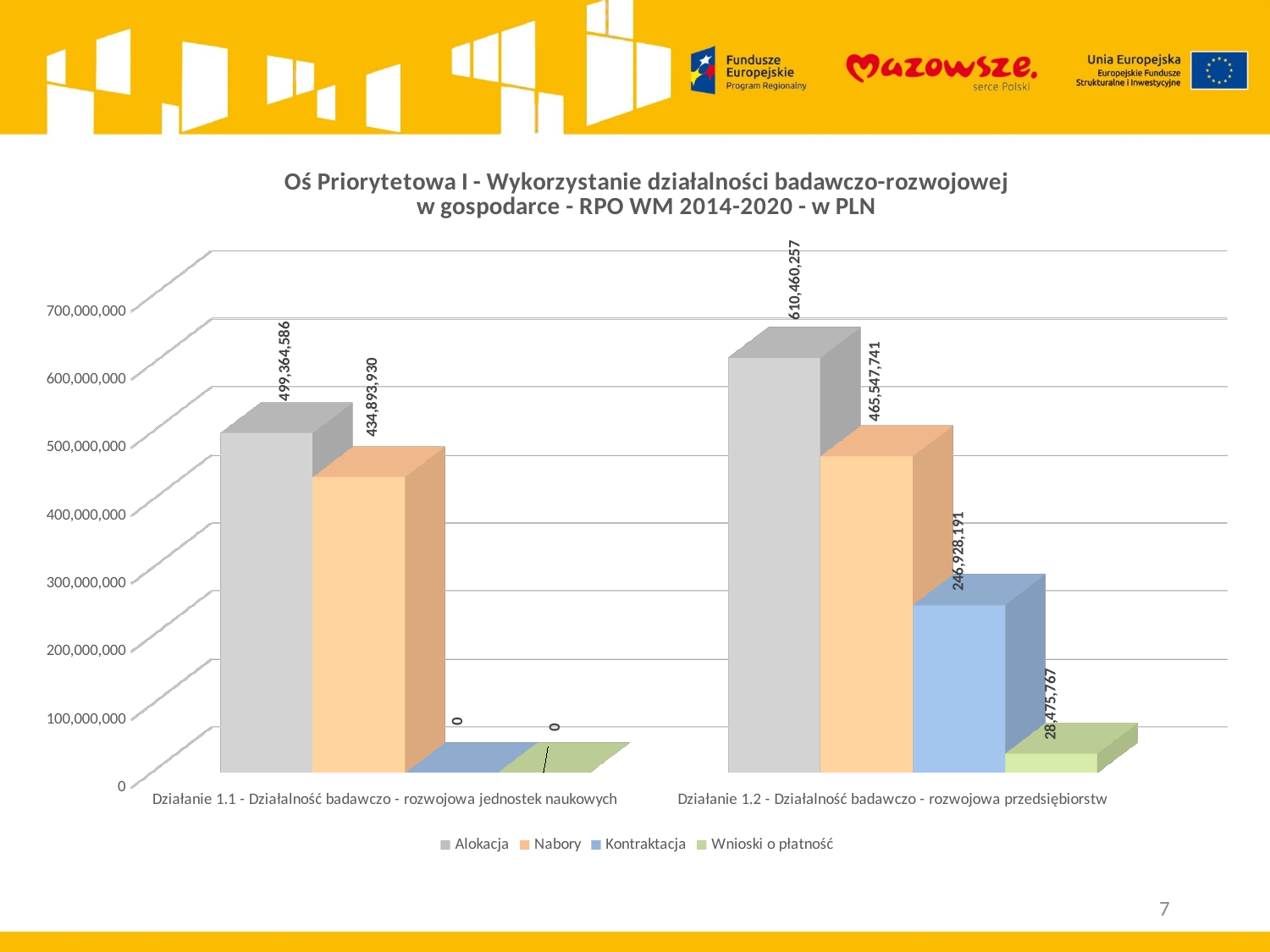
What is the Kontraktacja value for Działanie 1.2? 246,928,191 What is the difference between the Nabory values for Działanie 1.2 and Działanie 1.1? 30,653,811 How many series does the legend list? 4 Which is larger: the Kontraktacja value for Działanie 1.2 or the Nabory value for Działanie 1.1? Nabory for Działanie 1.1 What is the difference between the Alokacja values for Działanie 1.2 and Działanie 1.1? 111,095,671 Which series has the highest value for Działanie 1.2? Alokacja What is the Wnioski o płatność value for Działanie 1.1? 0 How many categories are shown on the x axis? 2 Which series has the lowest value for Działanie 1.2? Wnioski o płatność What kind of chart is shown on the slide? Bar chart What is the Nabory value for Działanie 1.1 - Działalność badawczo - rozwojowa jednostek naukowych? 434,893,930 What is the Alokacja value for Działanie 1.2 - Działalność badawczo - rozwojowa przedsiębiorstw? 610,460,257